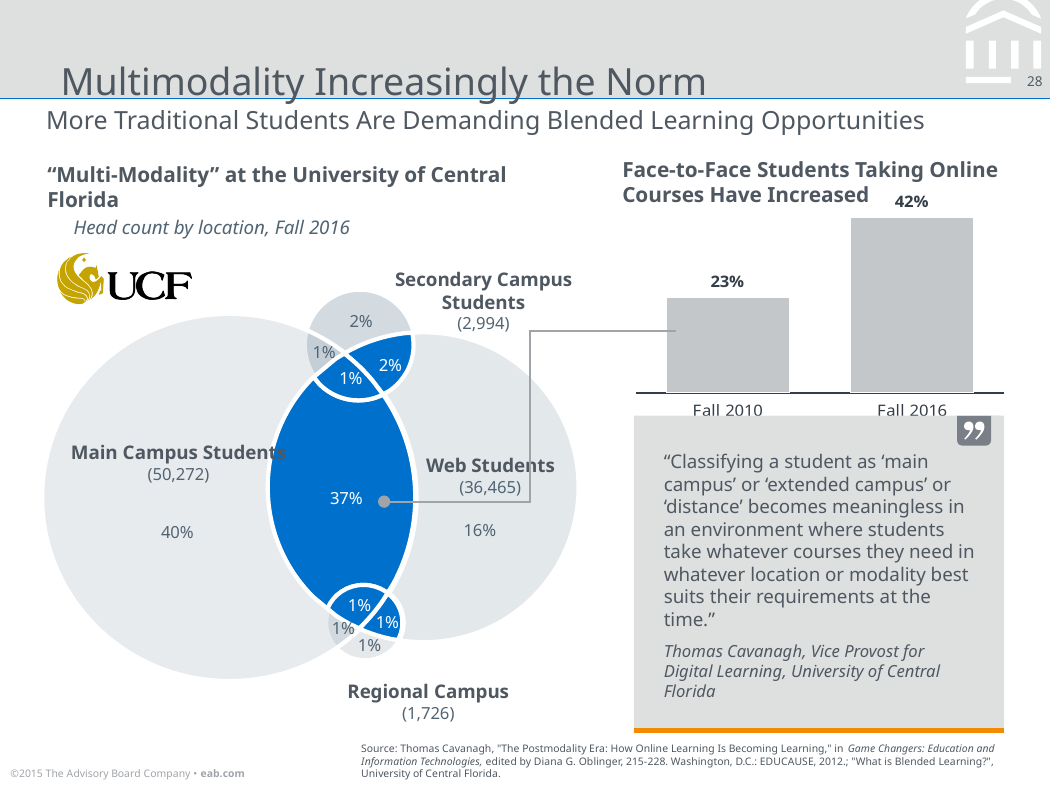
In the "Multi-Modality" at the University of Central Florida diagram, what is the head count for Main Campus Students? 50,272 In the "Multi-Modality" at the University of Central Florida diagram, what is the head count for Regional Campus? 1,726 In the chart titled "Face-to-Face Students Taking Online Courses Have Increased", by how many percentage points does Fall 2016 exceed Fall 2010? 19 percentage points What kind of chart is the one titled "Face-to-Face Students Taking Online Courses Have Increased"? Bar chart In the chart titled "Face-to-Face Students Taking Online Courses Have Increased", what is the value for Fall 2016? 42% In the chart titled "Face-to-Face Students Taking Online Courses Have Increased", do the values rise or fall from Fall 2010 to Fall 2016? Rise In the "Multi-Modality" at the University of Central Florida diagram, which group has the largest head count? Main Campus Students In the chart titled "Face-to-Face Students Taking Online Courses Have Increased", which period has the higher value, Fall 2010 or Fall 2016? Fall 2016 In the "Multi-Modality" at the University of Central Florida diagram, what is the head count for Web Students? 36,465 In the chart titled "Face-to-Face Students Taking Online Courses Have Increased", how many bars are plotted? 2 In the chart titled "Face-to-Face Students Taking Online Courses Have Increased", what is the value for Fall 2010? 23% In the "Multi-Modality" at the University of Central Florida diagram, what percentage is shown in the overlap between Main Campus Students and Web Students? 37%